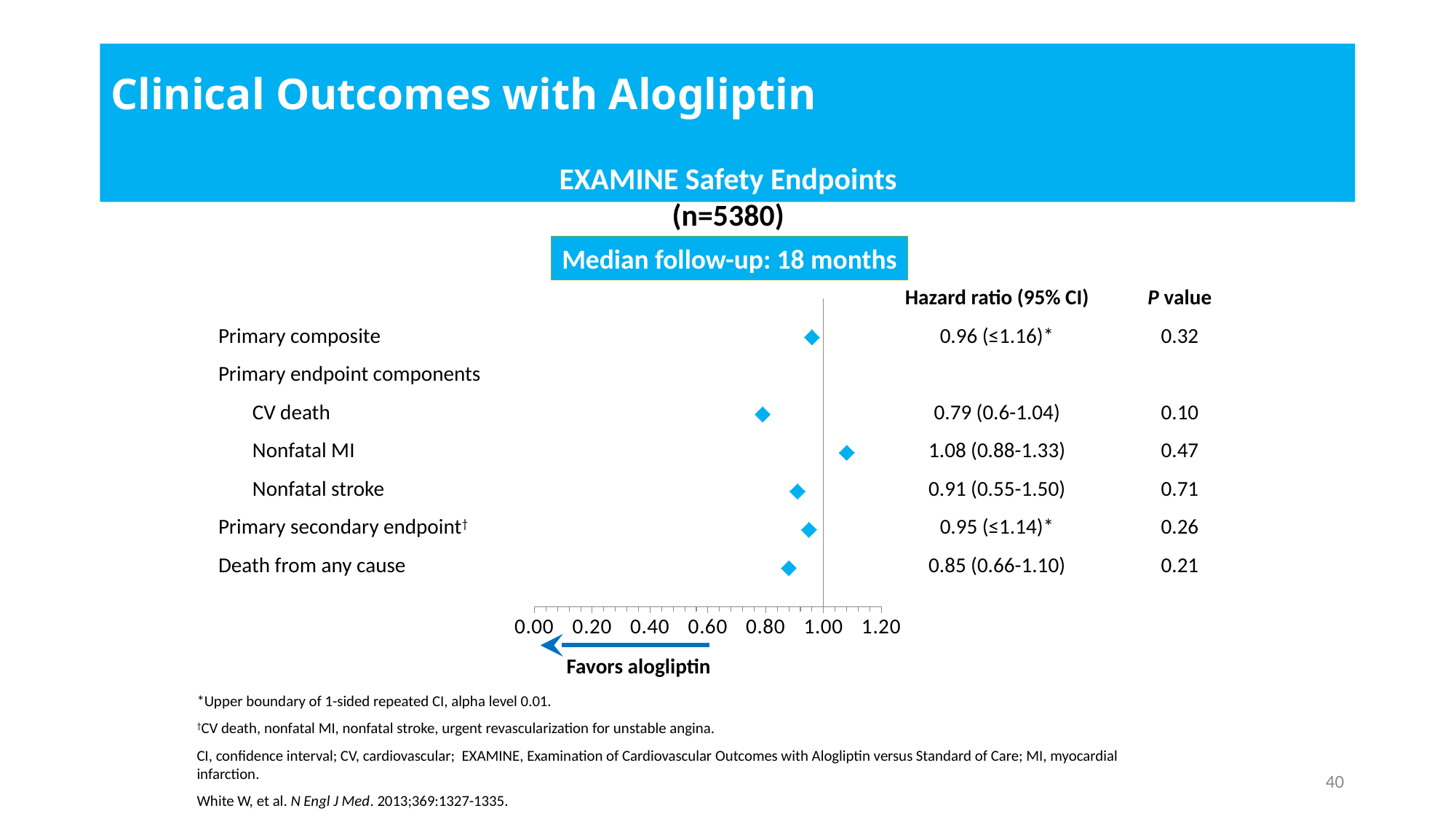
Which endpoint has the lowest hazard ratio? CV death Which endpoint has the highest hazard ratio? Nonfatal MI Which has the larger hazard ratio, nonfatal stroke or death from any cause? Nonfatal stroke What is the hazard ratio for nonfatal MI? 1.08 What is the hazard ratio for CV death? 0.79 What is the 95% CI for nonfatal stroke? 0.55-1.50 What is the difference between the hazard ratios for nonfatal MI and CV death? 0.29 Is the hazard ratio for nonfatal MI greater or less than 1.00? greater What is the hazard ratio for death from any cause? 0.85 How many endpoints have a hazard ratio plotted on the chart? 6 What is the P value for the primary composite endpoint? 0.32 What is the median follow-up stated on the slide? 18 months